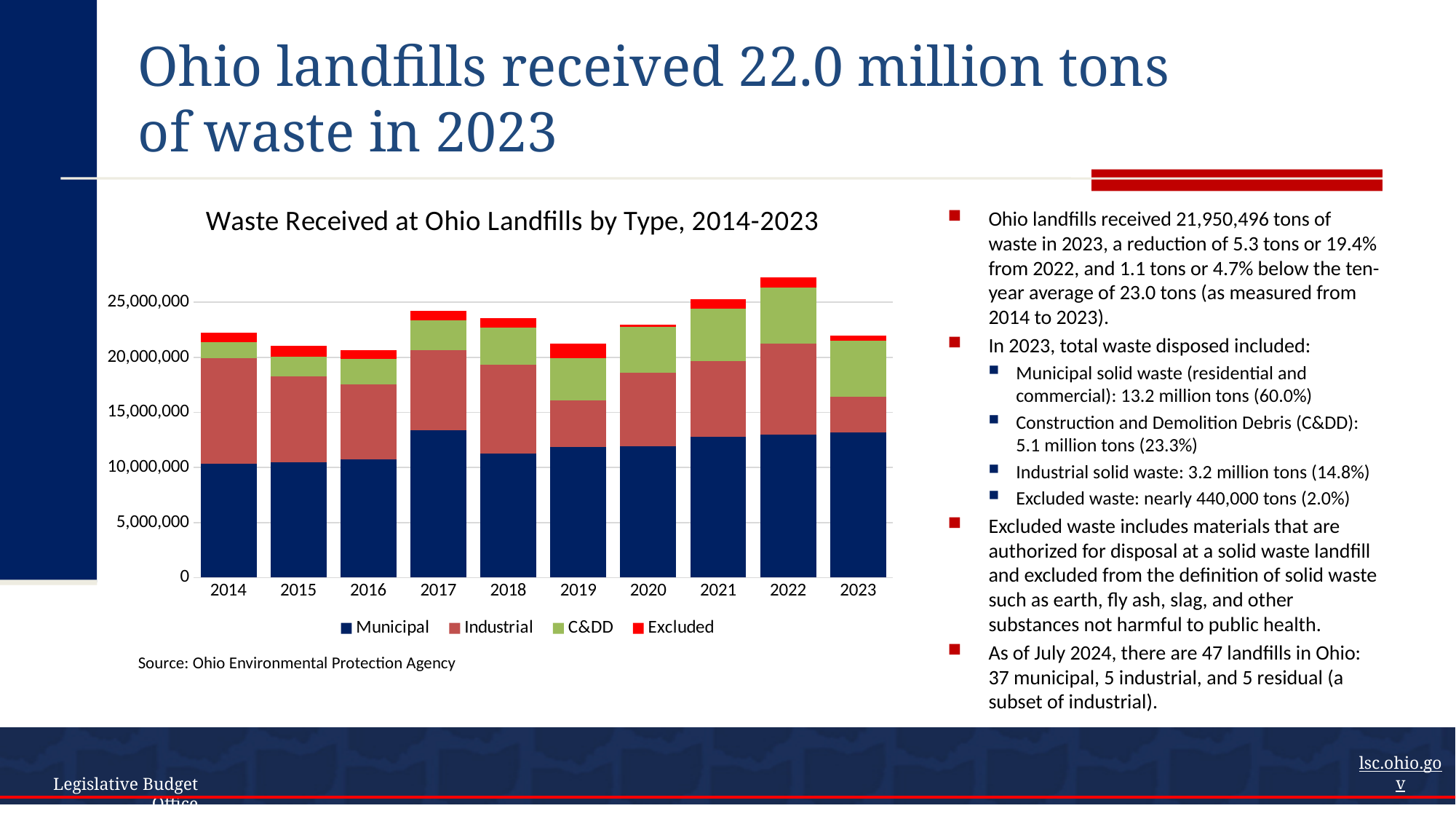
How many years are shown on the x axis of the chart? 10 Which year has the larger Municipal value, 2016 or 2017? 2017 Is the total waste received in 2019 greater or less than 20,000,000? greater What kind of chart is shown on the slide? Stacked bar chart Which year has the highest total waste received in the chart? 2022 Do the total bar heights rise or fall from 2019 to 2022? Rise Is the total waste received in 2014 greater or less than 25,000,000? less Which year has the larger total waste received, 2022 or 2023? 2022 Is the Municipal value for 2017 greater or less than 10,000,000? greater How many series does the chart legend list? 4 Which series is shown in red in the chart legend? Excluded